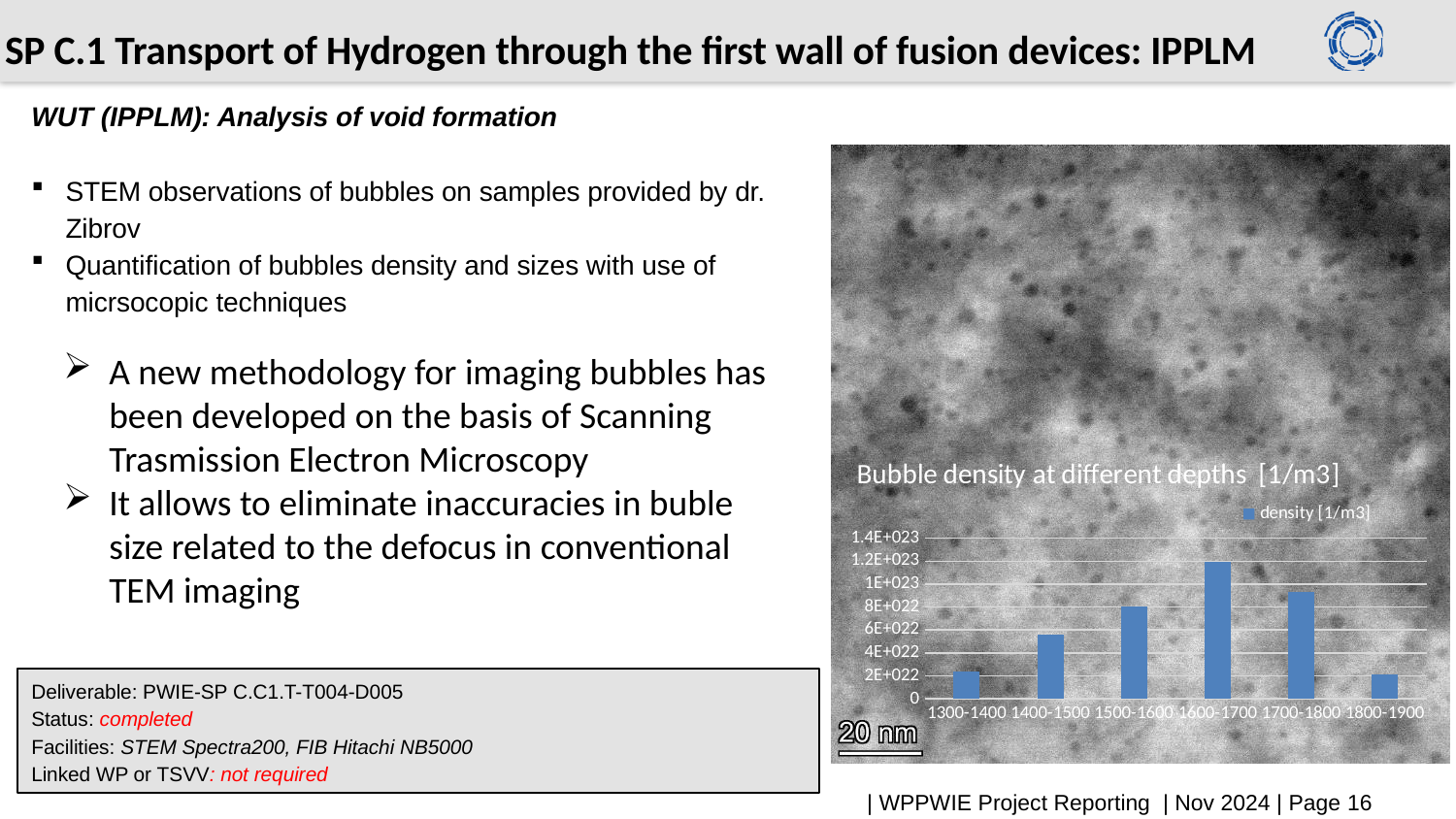
How many series does the chart legend list? 1 Which has the larger bubble density, 1600-1700 or 1700-1800? 1600-1700 Do the bubble density values rise or fall from 1300-1400 to 1600-1700? rise What kind of chart is shown on the slide? bar chart Is the bubble density for 1400-1500 greater or less than 4E+022? greater Is the bubble density for 1700-1800 greater or less than 8E+022? greater What is the title of the chart? Bubble density at different depths [1/m3] Which depth range has the lowest bubble density? 1800-1900 Which depth range has the highest bubble density? 1600-1700 How many depth categories are shown on the x axis of the chart? 6 Is the bubble density for 1600-1700 greater or less than 1E+023? greater